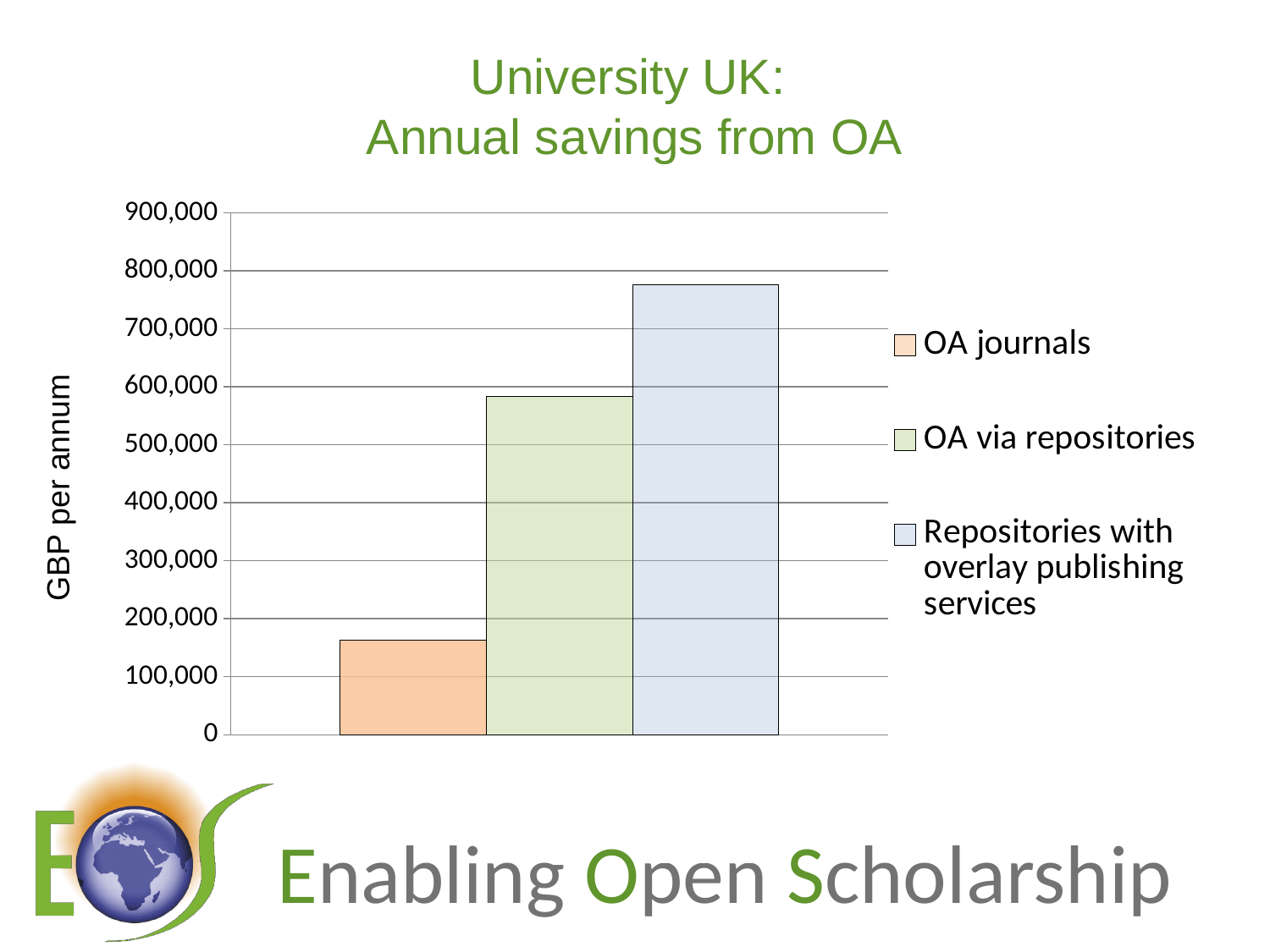
How many series does the legend list? 3 What is the highest value shown on the vertical axis? 900,000 Is the value for OA journals greater or less than 200,000? less Is the value for Repositories with overlay publishing services greater or less than 800,000? less What kind of chart is shown on the slide? bar chart Is the value for Repositories with overlay publishing services greater or less than 700,000? greater Which is larger, the value for OA via repositories or the value for Repositories with overlay publishing services? Repositories with overlay publishing services Which is larger, the value for OA journals or the value for OA via repositories? OA via repositories Which series has the lowest annual savings? OA journals Which series has the highest annual savings? Repositories with overlay publishing services What is the label on the vertical axis of the chart? GBP per annum